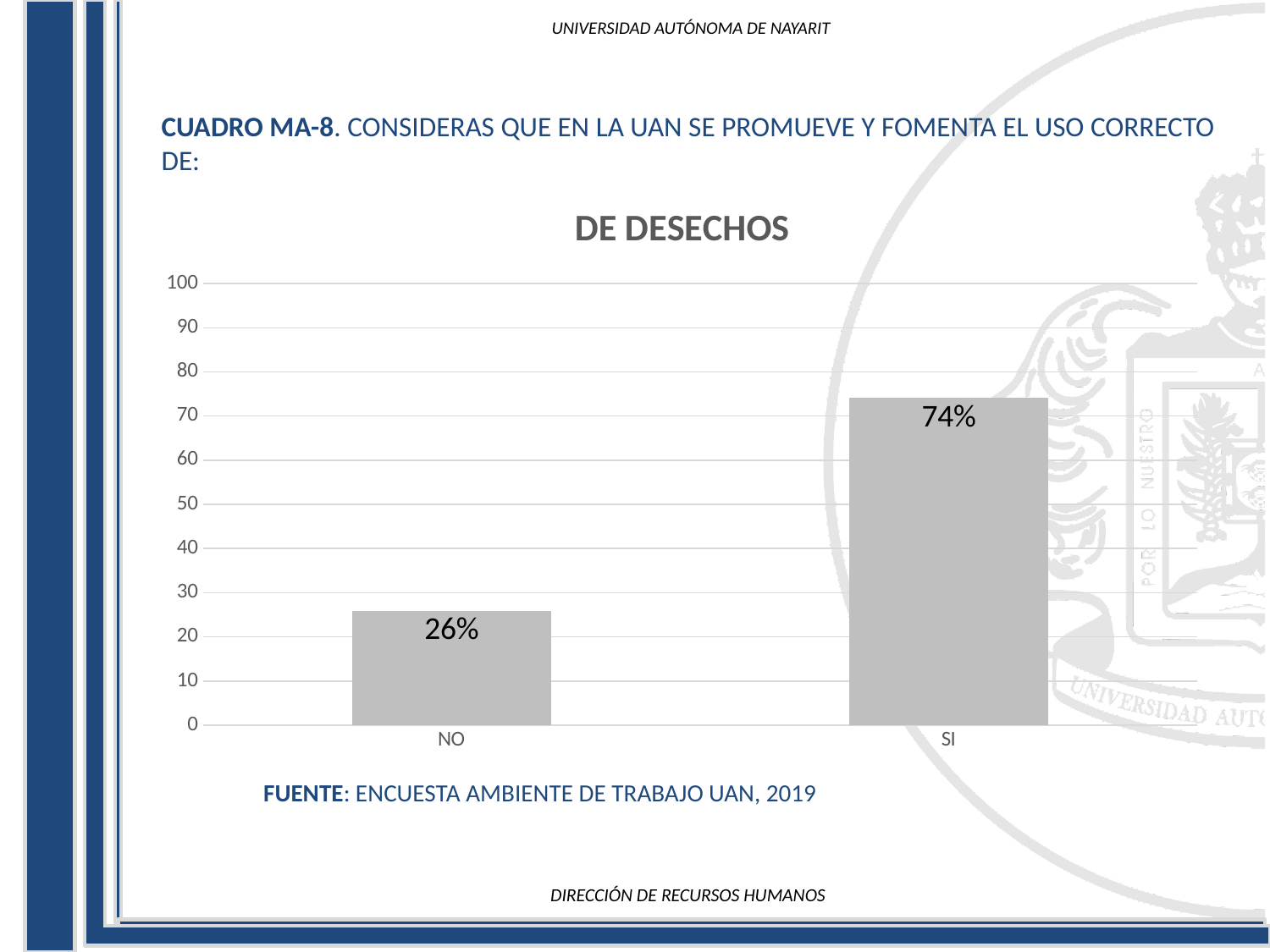
Which category has the highest value? SI Is the value for SI greater or less than 70? greater Which is larger, the value for NO or the value for SI? SI What is the value for NO? 26% What is the value for SI? 74% What kind of chart is shown? bar chart What is the title of the chart? DE DESECHOS How many categories are shown on the x axis? 2 Which category has the lowest value? NO Is the value for NO greater or less than 30? less What is the highest value shown on the y axis? 100 What is the difference between the values for SI and NO? 48%